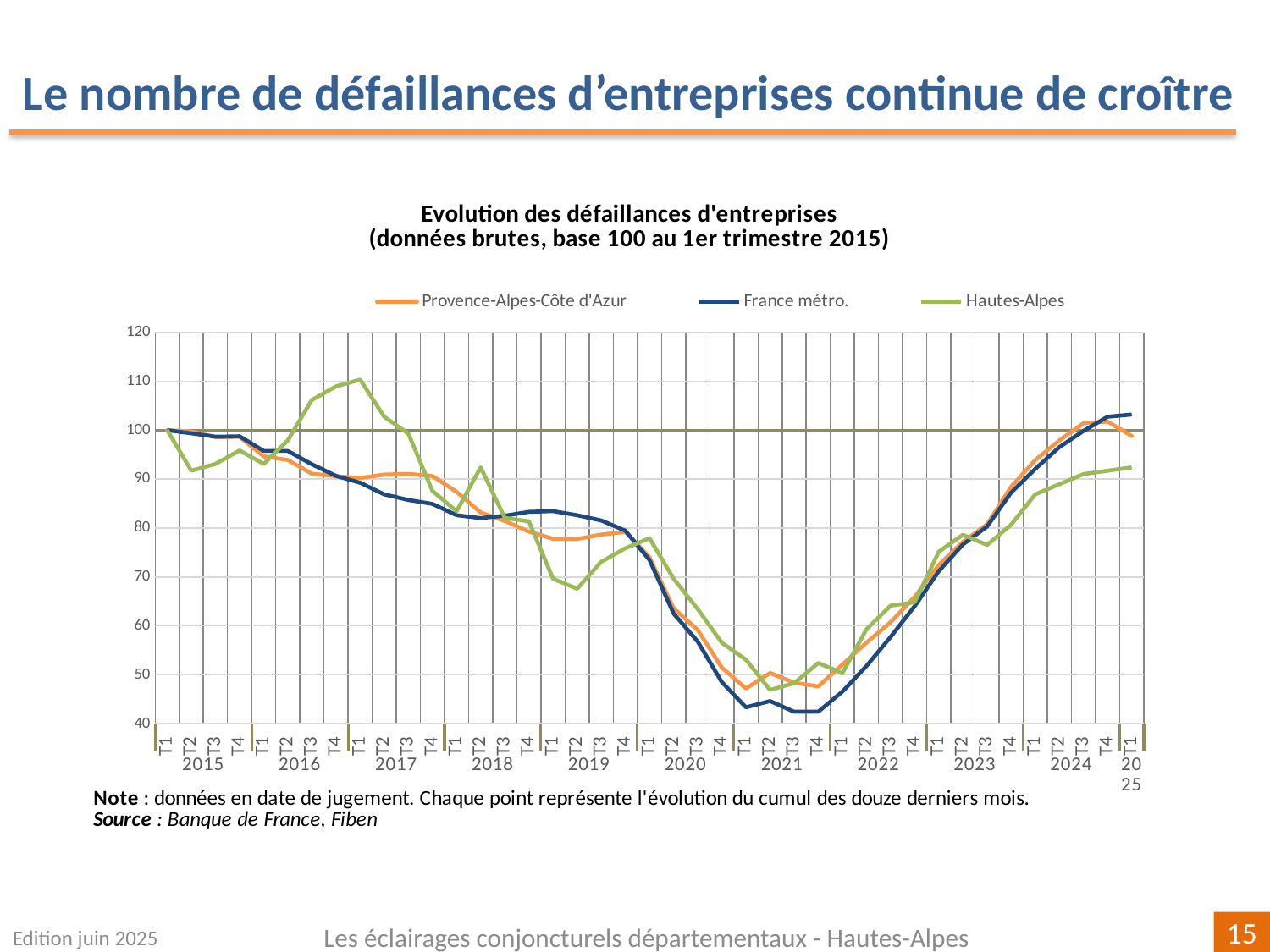
What kind of chart is shown on the slide? line chart At T1 2017, which series is higher: Hautes-Alpes or Provence-Alpes-Côte d'Azur? Hautes-Alpes Is the value for Hautes-Alpes at T1 2025 greater or less than 90? greater In which quarter does the Hautes-Alpes series reach its highest value? T1 2017 Is the value for Provence-Alpes-Côte d'Azur at T1 2018 greater or less than 80? greater How many series does the legend list? 3 Is the value for France métro. at T4 2021 greater or less than 50? less Does the France métro. series rise or fall between T4 2021 and T1 2025? rise At T1 2025, which series is higher: France métro. or Hautes-Alpes? France métro. Which series is drawn in green? Hautes-Alpes What is the value of the France métro. series at T1 2015? 100